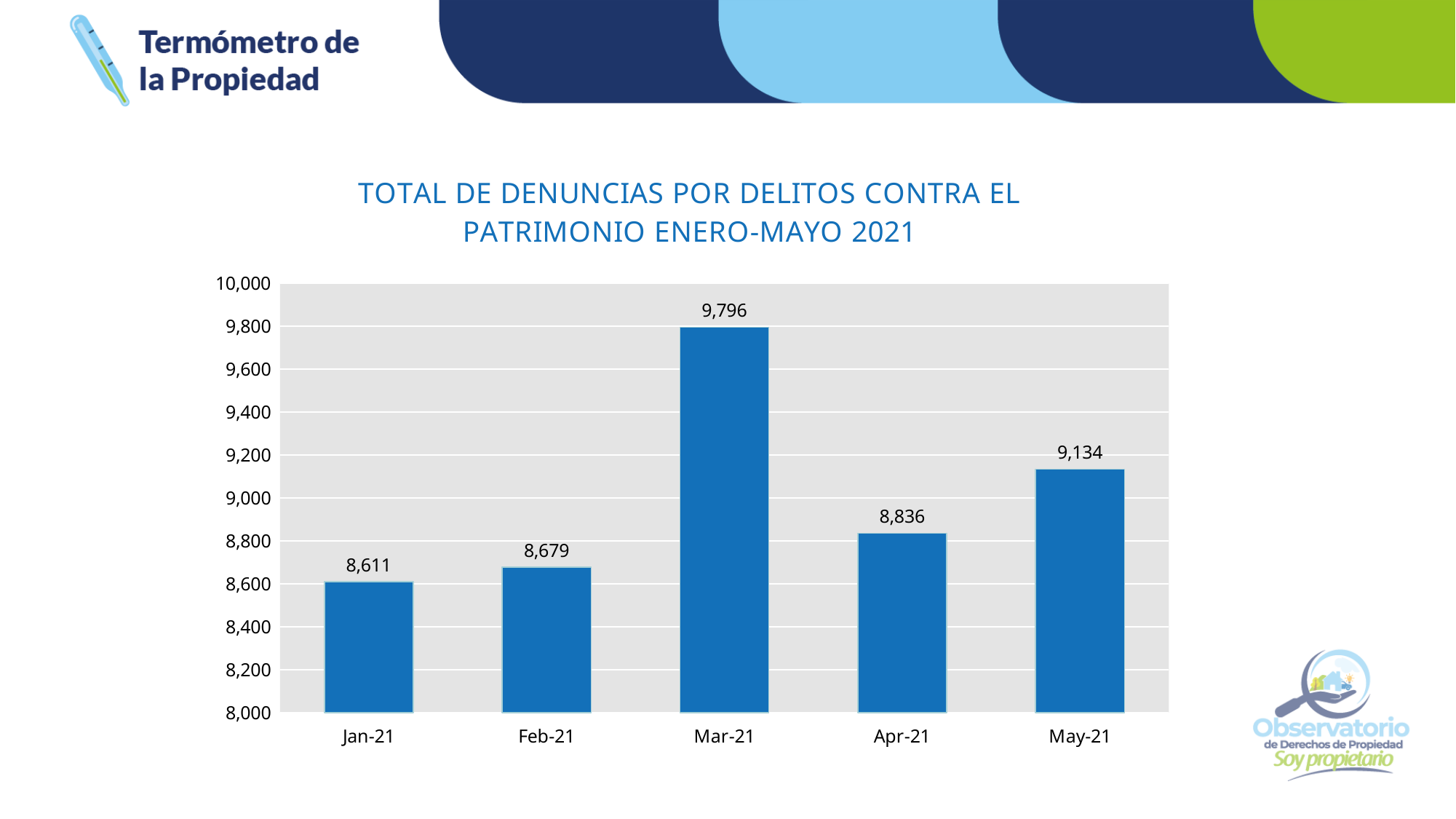
What is the value for May-21? 9,134 What is the difference between the values for Feb-21 and Jan-21? 68 What is the value for Jan-21? 8,611 How many months are shown on the x axis? 5 Which is larger, the value for Apr-21 or the value for May-21? May-21 What kind of chart is shown on the slide? bar chart Which month has the highest value? Mar-21 What is the difference between the values for Mar-21 and Apr-21? 960 What is the title of the chart? TOTAL DE DENUNCIAS POR DELITOS CONTRA EL PATRIMONIO ENERO-MAYO 2021 What is the value for Mar-21? 9,796 Is the value for Apr-21 greater or less than 9,000? less Which month has the lowest value? Jan-21